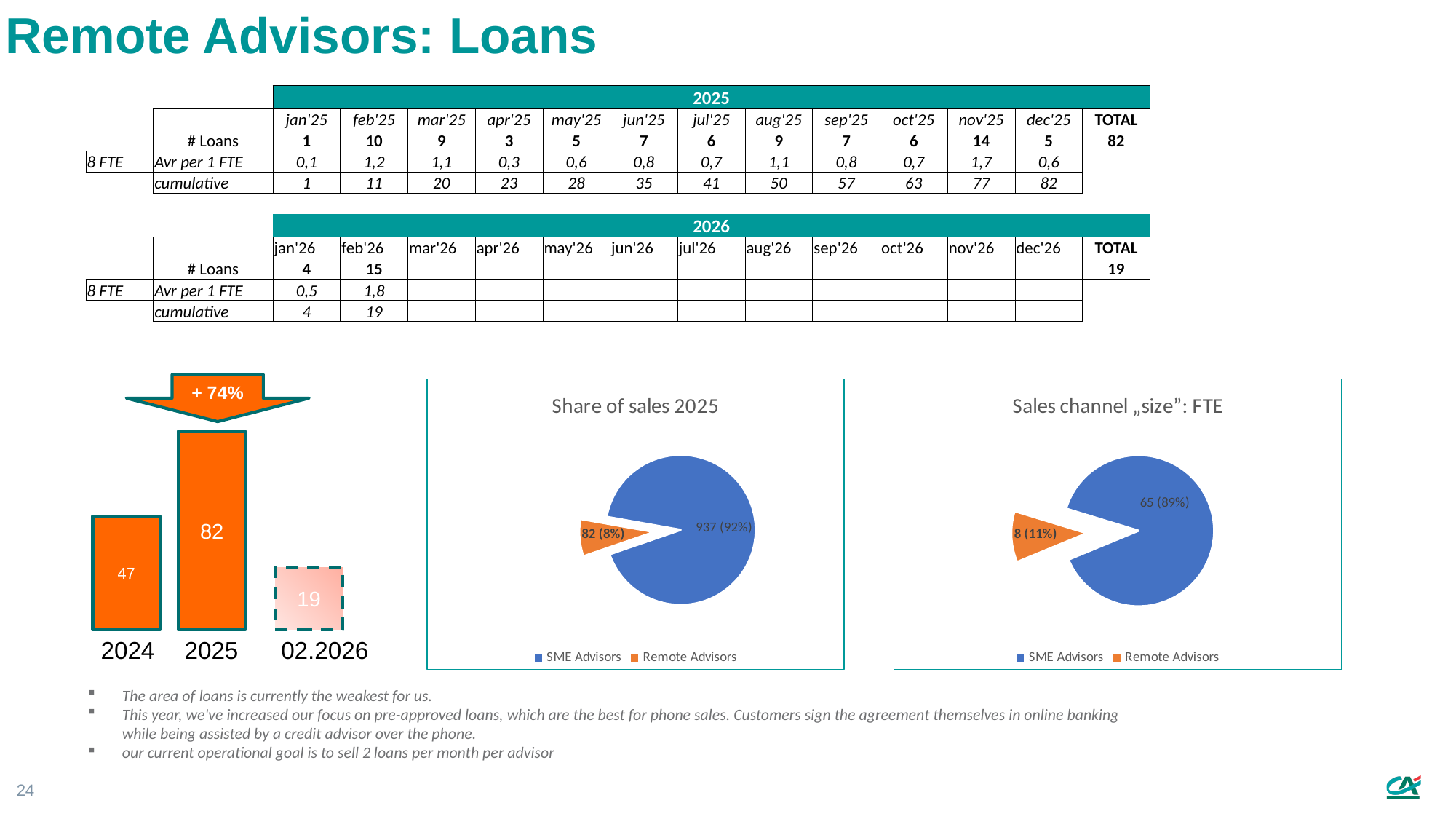
In the 'Share of sales 2025' chart, what share of the pie do SME Advisors hold? 92% In the bar chart on the left, which category has the highest value? 2025 In the bar chart on the left, what is the value for 2024? 47 In the bar chart on the left, how many bars are shown? 3 In the bar chart on the left, what is the difference between the 2025 and 2024 values? 35 In the bar chart on the left, which category has the lowest value? 02.2026 In the bar chart on the left, what is the value for 2025? 82 What kind of chart is the 'Share of sales 2025' chart? Pie chart In the 'Sales channel „size": FTE' chart, what is the value shown for Remote Advisors? 8 (11%) In the 'Sales channel „size": FTE' chart, which slice is larger, SME Advisors or Remote Advisors? SME Advisors In the 'Share of sales 2025' chart, what is the value shown for Remote Advisors? 82 (8%) How many entries does the legend of the 'Sales channel „size": FTE' chart list? 2